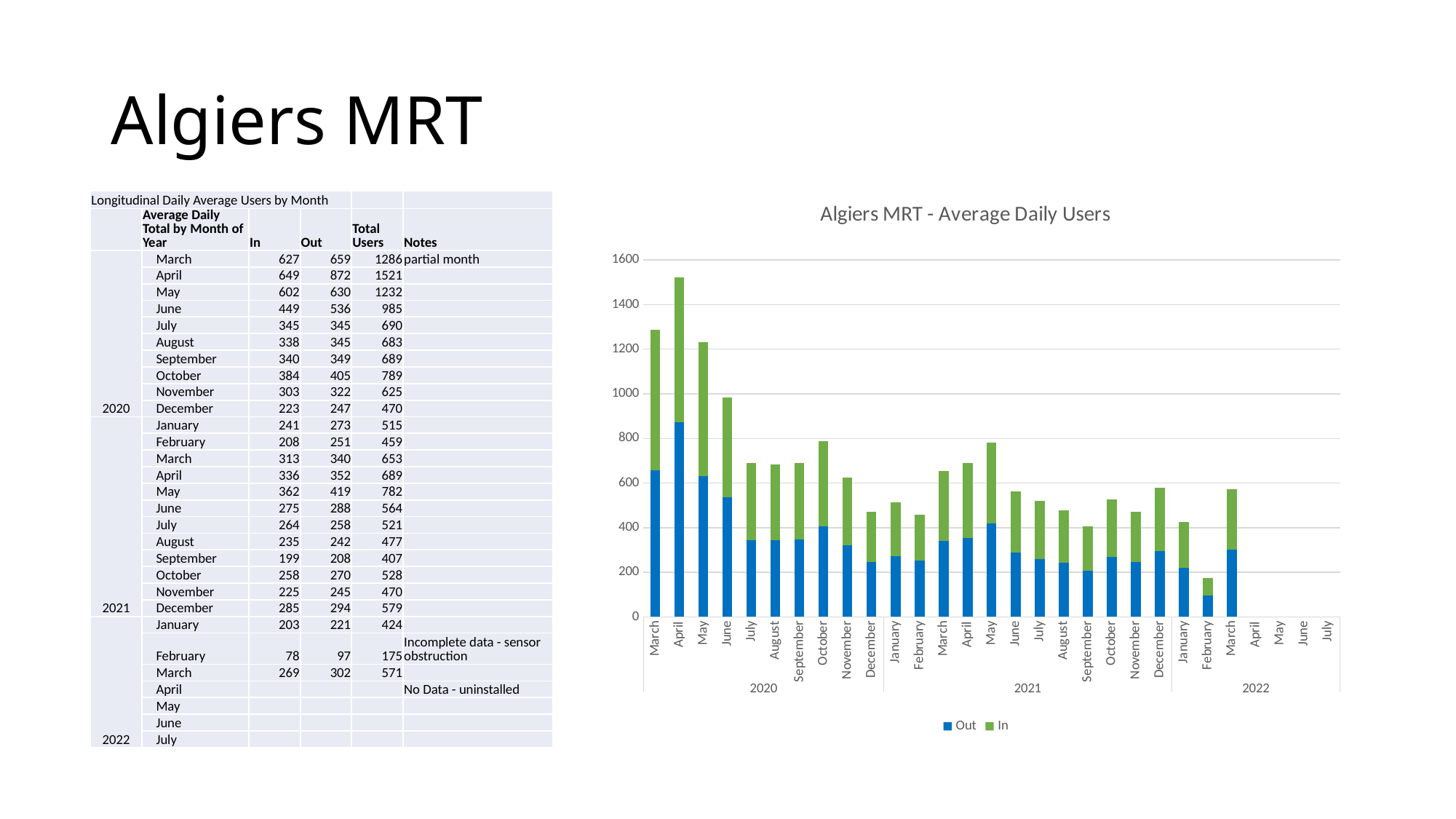
What is the title of the chart? Algiers MRT - Average Daily Users What kind of chart is shown on the slide? bar chart Do the stacked bar totals generally rise or fall from March 2020 to December 2020? fall Which has the larger total stacked bar, June 2020 or July 2020? June 2020 Is the total stacked bar for April 2020 greater or less than 1400? greater Is the total stacked bar for February 2022 greater or less than 200? less Which month with a plotted bar has the shortest stacked bar in the chart? February 2022 Which month has the tallest stacked bar in the chart? April 2020 How many year groups are labelled along the x axis of the chart? 3 How many series does the chart legend list? 2 What are the two series named in the chart legend? Out and In According to the table on the slide, what is the Total Users value for April 2020? 1521